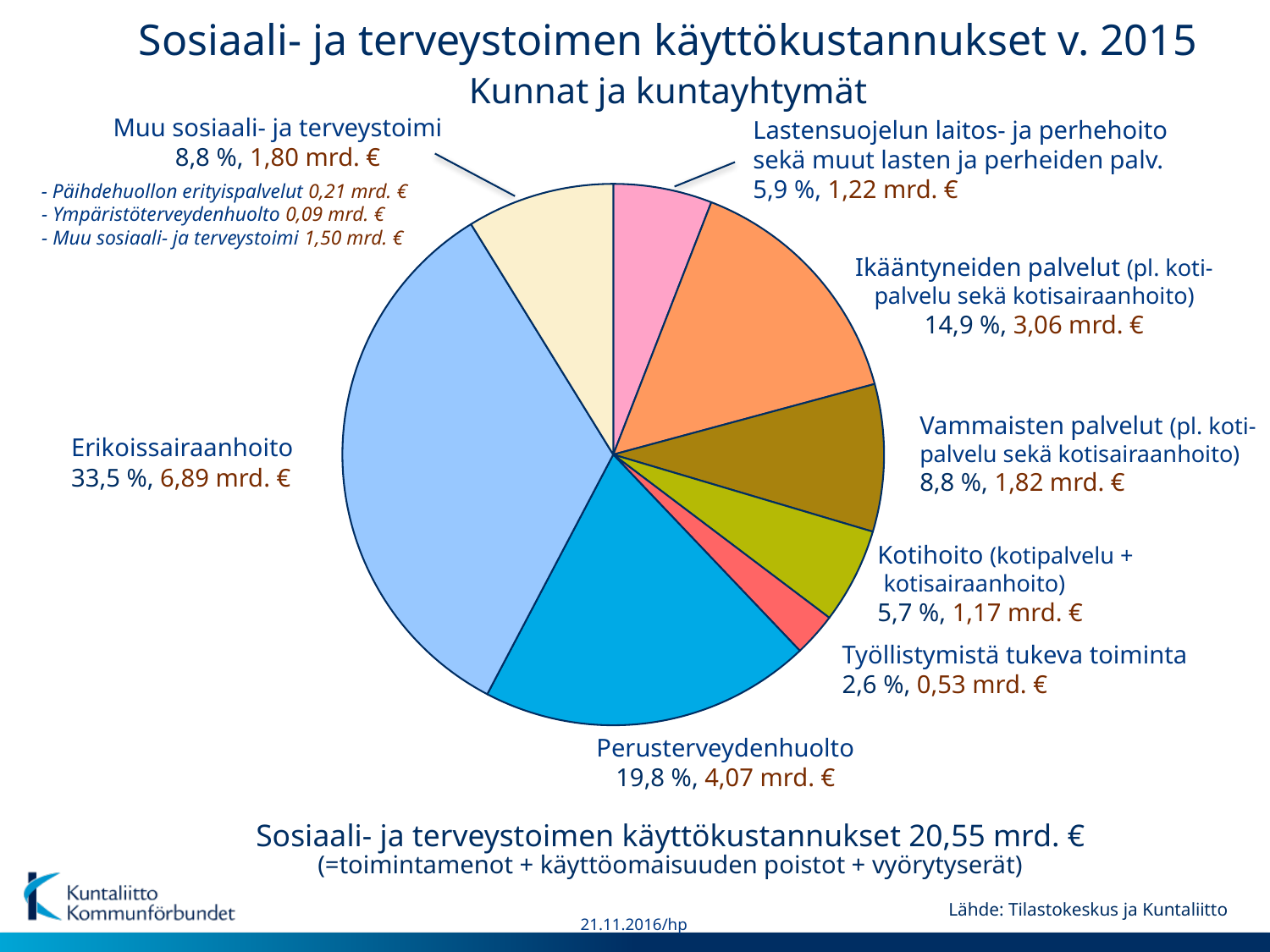
What is the value in mrd. € for Perusterveydenhuolto? 4,07 mrd. € What total value in mrd. € is stated below the chart for Sosiaali- ja terveystoimen käyttökustannukset? 20,55 mrd. € Which is larger in mrd. €: Vammaisten palvelut or Kotihoito? Vammaisten palvelut What kind of chart is shown on the slide? pie chart Which category has the largest slice of the pie? Erikoissairaanhoito How many slices does the pie chart have? 8 What is the difference in mrd. € between Erikoissairaanhoito and Perusterveydenhuolto? 2,82 mrd. € What percentage share is shown for Työllistymistä tukeva toiminta? 2,6 % What is the value in mrd. € for Ikääntyneiden palvelut? 3,06 mrd. € What is the difference in percentage points between Ikääntyneiden palvelut and Lastensuojelun laitos- ja perhehoito? 9,0 % What share of the pie does Erikoissairaanhoito represent? 33,5 % Which category has the smallest slice of the pie? Työllistymistä tukeva toiminta